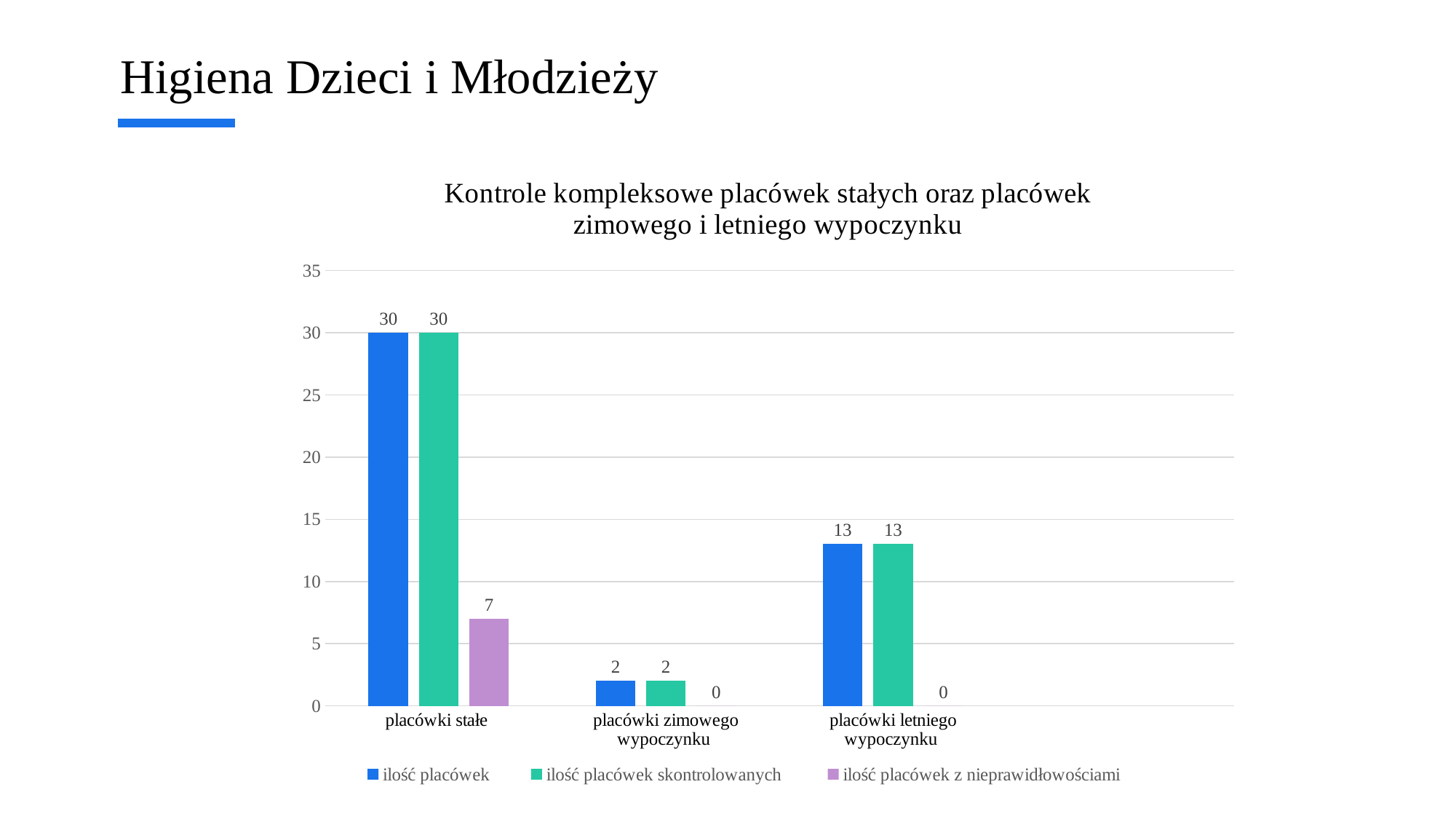
What is the difference between 'ilość placówek skontrolowanych' and 'ilość placówek z nieprawidłowościami' for 'placówki stałe'? 23 How many series does the legend list? 3 What is the value of 'ilość placówek' for 'placówki zimowego wypoczynku'? 2 Which is larger: 'ilość placówek' for 'placówki letniego wypoczynku' or for 'placówki zimowego wypoczynku'? placówki letniego wypoczynku What is the value of 'ilość placówek skontrolowanych' for 'placówki letniego wypoczynku'? 13 How many categories are shown on the x axis? 3 Which category has the highest value for 'ilość placówek'? placówki stałe What is the value of 'ilość placówek' for 'placówki stałe'? 30 What is the value of 'ilość placówek z nieprawidłowościami' for 'placówki stałe'? 7 Which category has the lowest value for 'ilość placówek skontrolowanych'? placówki zimowego wypoczynku What is the title of the chart? Kontrole kompleksowe placówek stałych oraz placówek zimowego i letniego wypoczynku What kind of chart is shown on the slide? bar chart